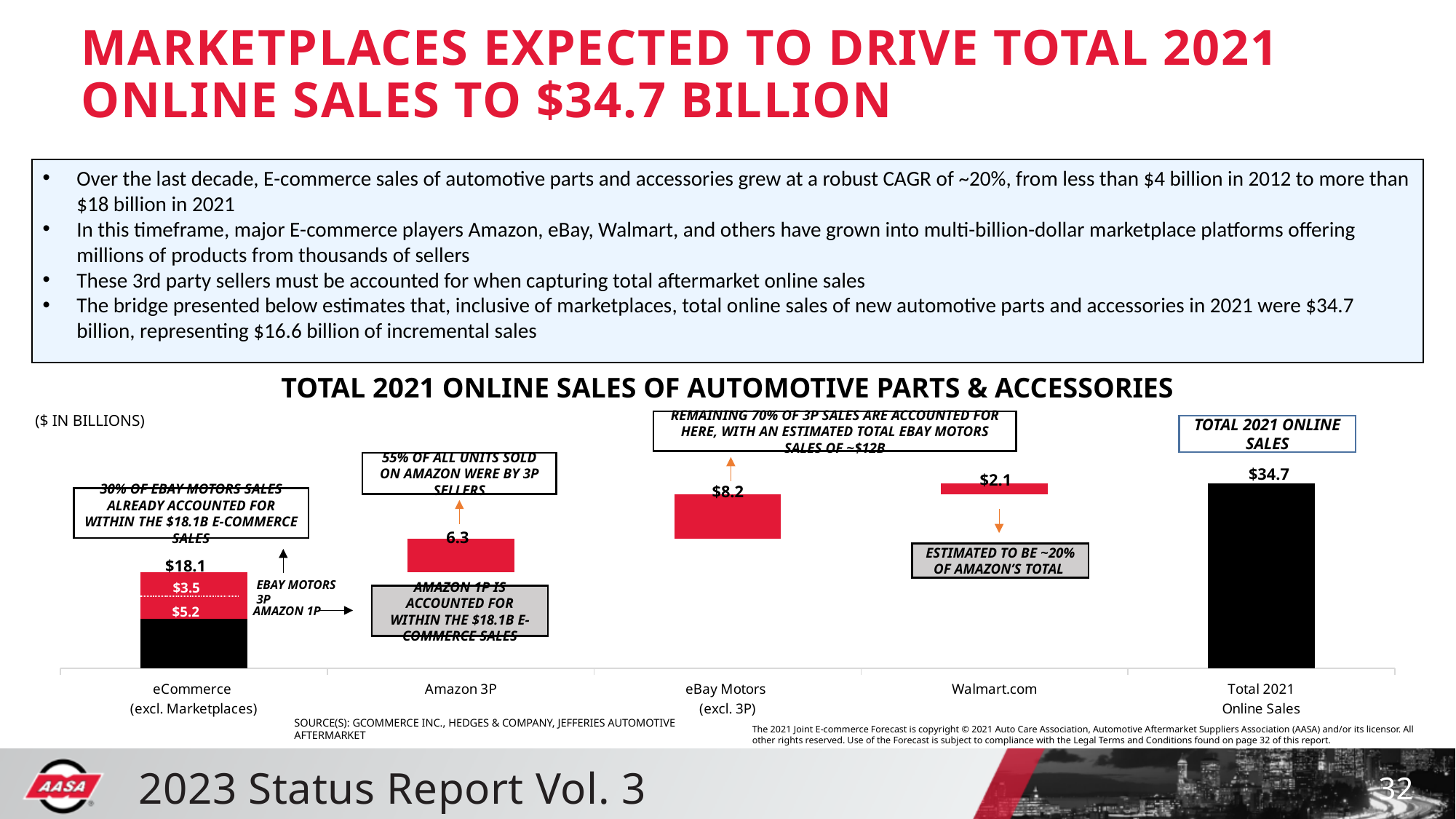
What is the value shown for eBay Motors (excl. 3P)? $8.2 What is the value shown for eCommerce (excl. Marketplaces)? $18.1 What is the title of the chart? TOTAL 2021 ONLINE SALES OF AUTOMOTIVE PARTS & ACCESSORIES What is the difference between the eBay Motors (excl. 3P) value and the Walmart.com value? $6.1 What is the value shown for Walmart.com? $2.1 How many categories are shown along the x axis of the chart? 5 What unit is stated for the values in the chart? $ in billions Which marketplace category (Amazon 3P, eBay Motors, or Walmart.com) has the highest value? eBay Motors (excl. 3P) Which is larger, the value for Amazon 3P or the value for eBay Motors (excl. 3P)? eBay Motors (excl. 3P) What is the value for Total 2021 Online Sales in the chart? $34.7 Which marketplace category (Amazon 3P, eBay Motors, or Walmart.com) has the lowest value? Walmart.com What is the value shown for Amazon 3P? 6.3